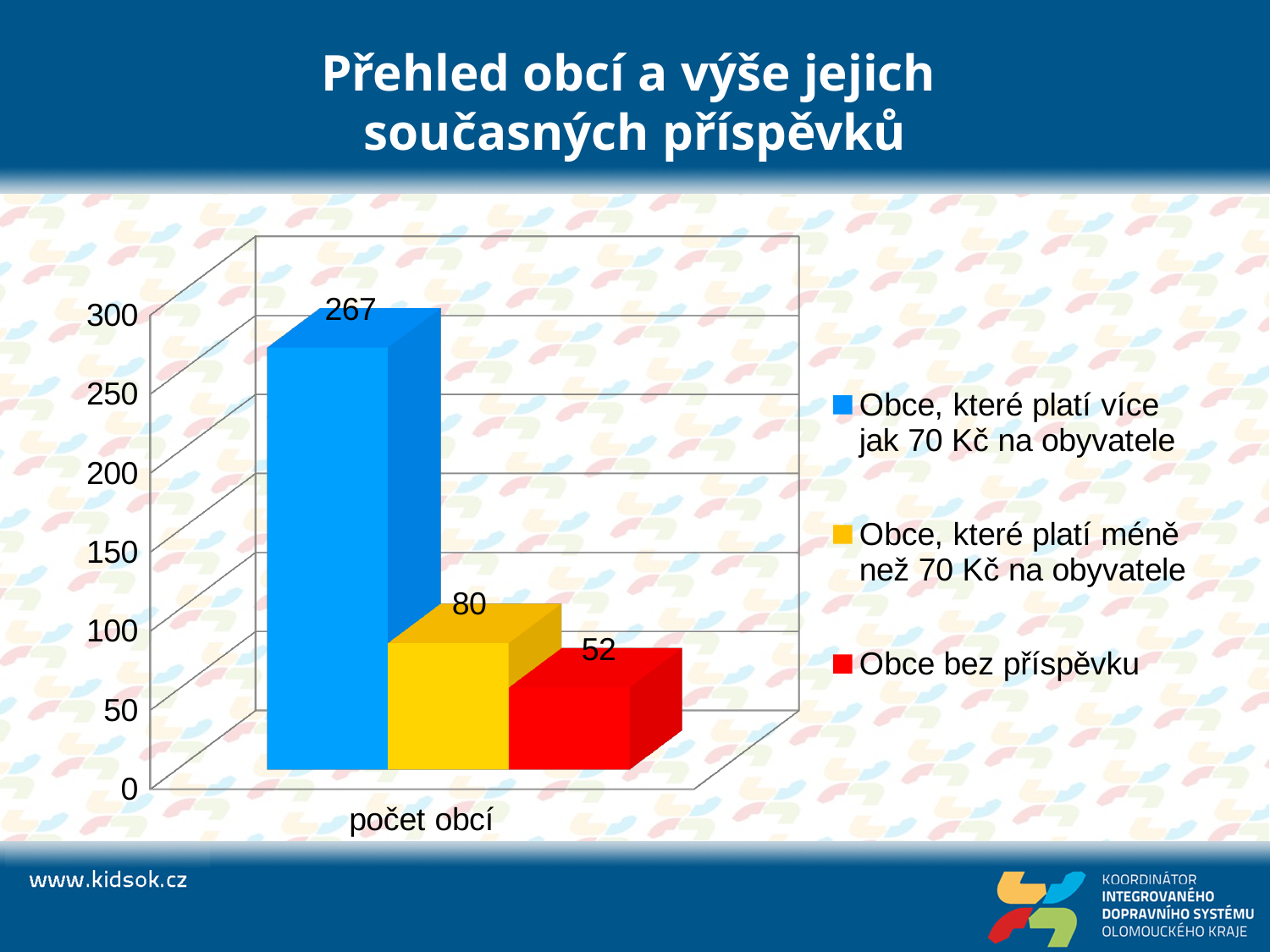
What kind of chart is shown on the slide? Bar chart Which series has the lowest value? Obce bez příspěvku What is the value for 'Obce bez příspěvku'? 52 What is the difference between the value for 'Obce, které platí méně než 70 Kč na obyvatele' and the value for 'Obce bez příspěvku'? 28 What is the value for 'Obce, které platí méně než 70 Kč na obyvatele'? 80 Which is larger: the value for 'Obce, které platí méně než 70 Kč na obyvatele' or the value for 'Obce bez příspěvku'? Obce, které platí méně než 70 Kč na obyvatele What is the category label shown on the x axis? počet obcí What is the difference between the value for 'Obce, které platí více jak 70 Kč na obyvatele' and the value for 'Obce bez příspěvku'? 215 What is the value for 'Obce, které platí více jak 70 Kč na obyvatele'? 267 Which series has the highest value? Obce, které platí více jak 70 Kč na obyvatele How many series does the legend list? 3 What colour is the bar for 'Obce bez příspěvku'? Red